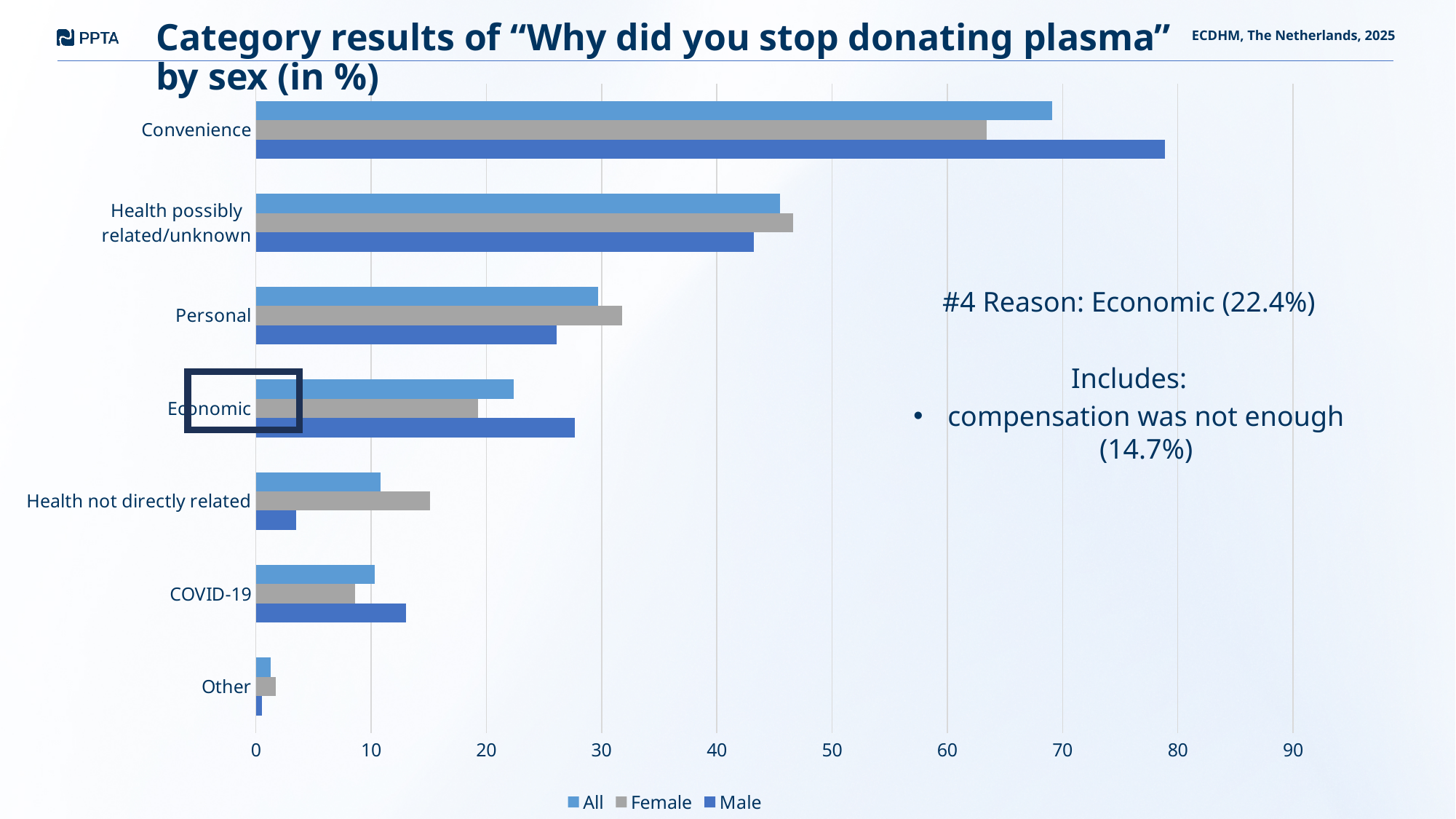
How many reason categories are plotted on the chart? 7 What is the All value for the Economic category, as stated on the slide? 22.4% For the Convenience category, which is larger: the Male value or the Female value? Male For the Health not directly related category, which is larger: the Female value or the Male value? Female How many series does the legend list? 3 Which category has the lowest value for the Male series? Other Which series is shown in grey in the legend? Female Which category has the highest value for the All series? Convenience Is the Male value for Convenience greater or less than 70? greater What kind of chart is shown on the slide? bar chart Is the Male value for COVID-19 greater or less than 20? less Is the Female value for Personal greater or less than 30? greater